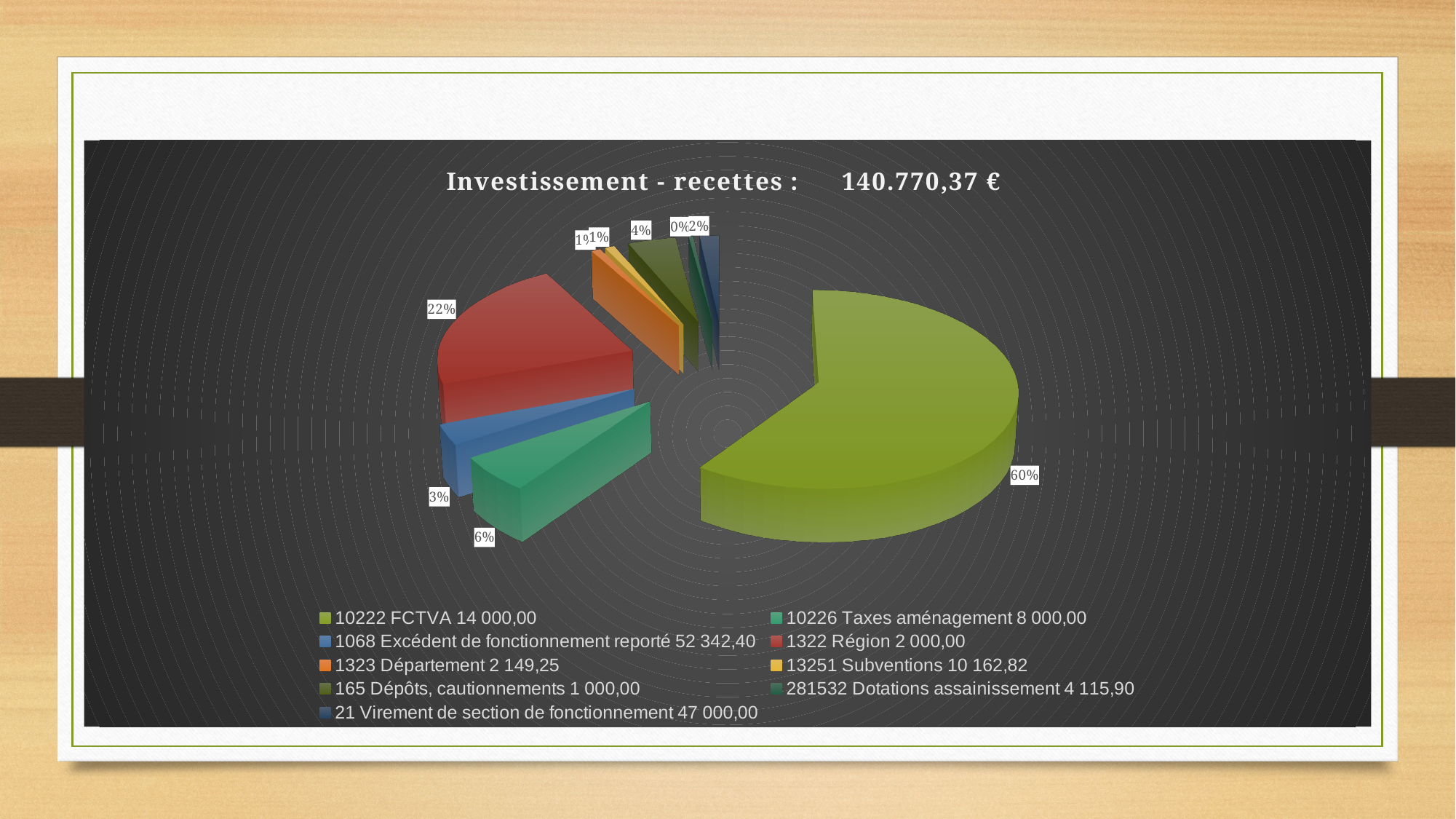
What percentage label is shown on the olive slice (165 Dépôts, cautionnements)? 4% What is the title of the chart? Investissement - recettes : 140.770,37 € What amount is given in the legend for 281532 Dotations assainissement? 4 115,90 What percentage label is shown on the red slice (1322 Région)? 22% What amount is given in the legend for 13251 Subventions? 10 162,82 How many categories does the legend of the pie chart list? 9 What kind of chart is shown on the slide? pie chart What amount is given in the legend for 1068 Excédent de fonctionnement reporté? 52 342,40 Which slice shows a larger percentage label, the red slice (1322 Région) or the blue slice (1068 Excédent de fonctionnement reporté)? 1322 Région What percentage label is shown on the teal slice (10226 Taxes aménagement)? 6% Which category has the largest slice of the pie chart? 10222 FCTVA